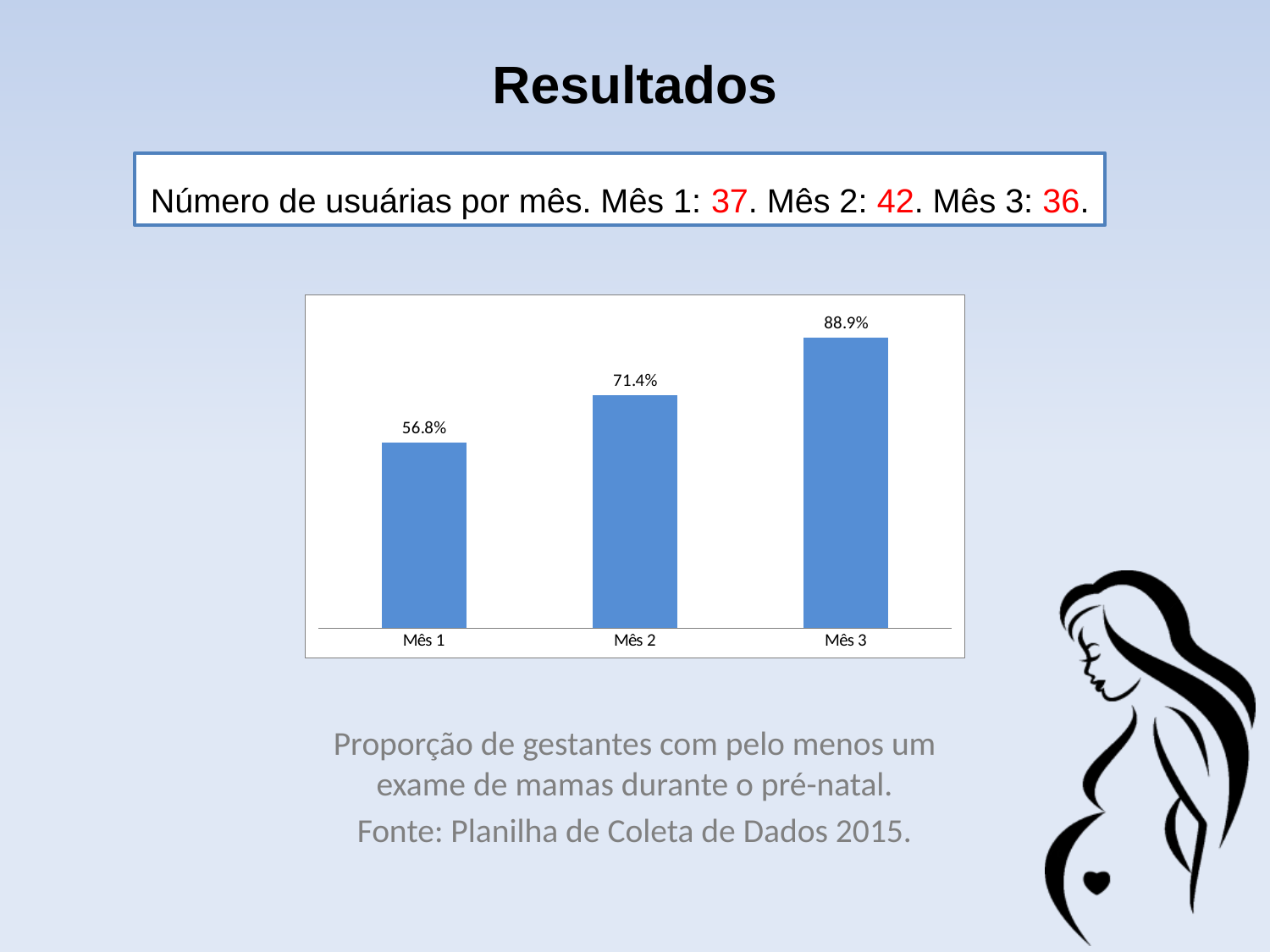
Which month has the lowest value? Mês 1 What is the difference between the values for Mês 3 and Mês 1? 32.1% What colour are the bars in the chart? blue What is the value for Mês 3? 88.9% Which month has the highest value? Mês 3 Which is larger, the value for Mês 2 or the value for Mês 3? Mês 3 What kind of chart is shown on the slide? bar chart What is the value for Mês 1? 56.8% What is the value for Mês 2? 71.4% What is the difference between the values for Mês 2 and Mês 1? 14.6% Do the values rise or fall from Mês 1 to Mês 3? rise How many months are shown in the chart? 3